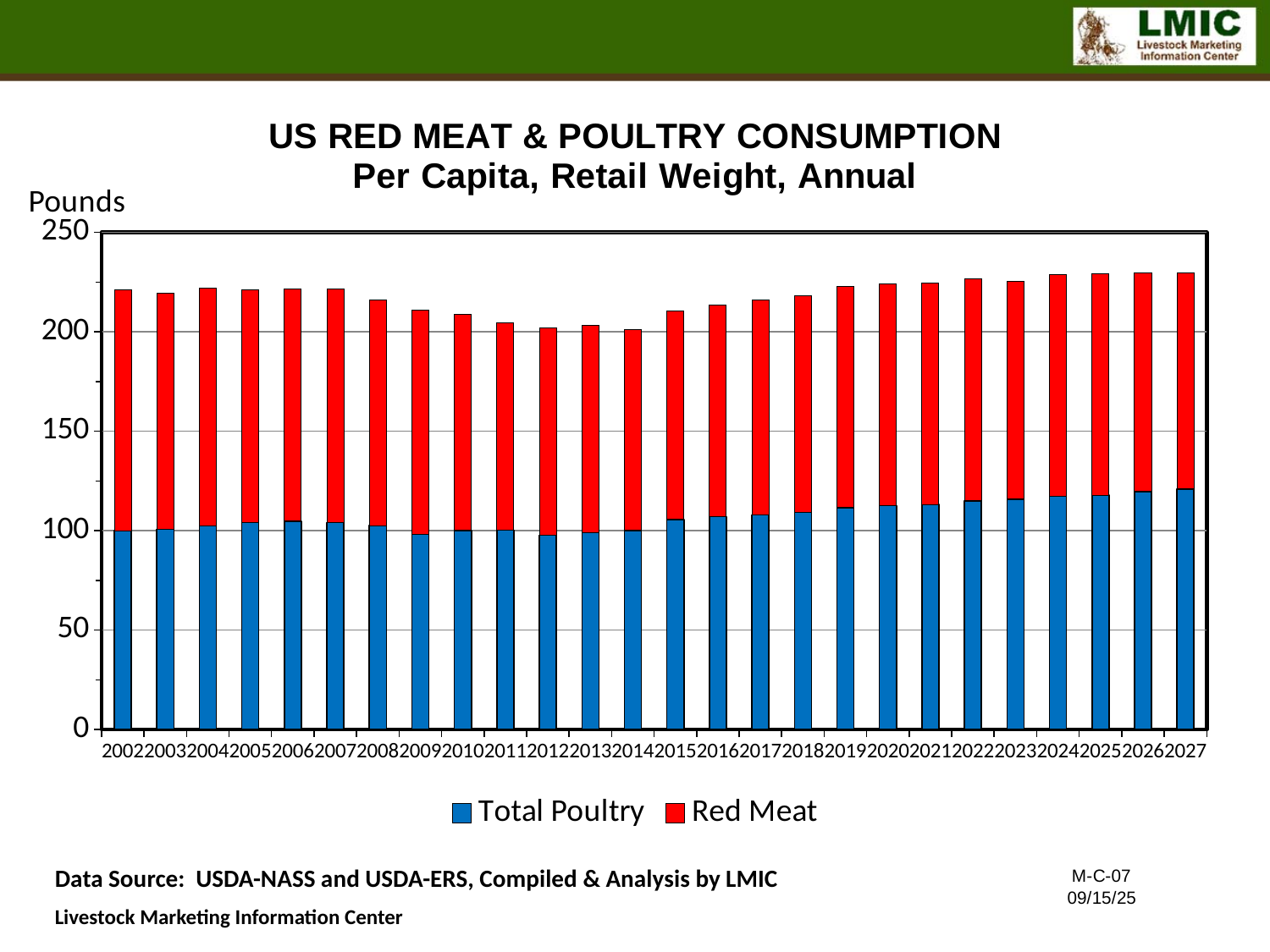
Does the Total Poultry series rise or fall from 2014 to 2027? rise How many series does the legend list? 2 Which two series are listed in the legend? Total Poultry and Red Meat Which year has the larger Total Poultry value, 2002 or 2027? 2027 Is the total stacked bar for 2027 greater or less than 200? greater Is the Total Poultry value for 2027 greater or less than 100? greater Is the total stacked bar for 2002 greater or less than 200? greater Which year has the larger total stacked bar, 2014 or 2027? 2027 What is the unit shown on the y axis? Pounds How many years are shown along the x axis? 26 What kind of chart is shown on the slide? Stacked bar chart